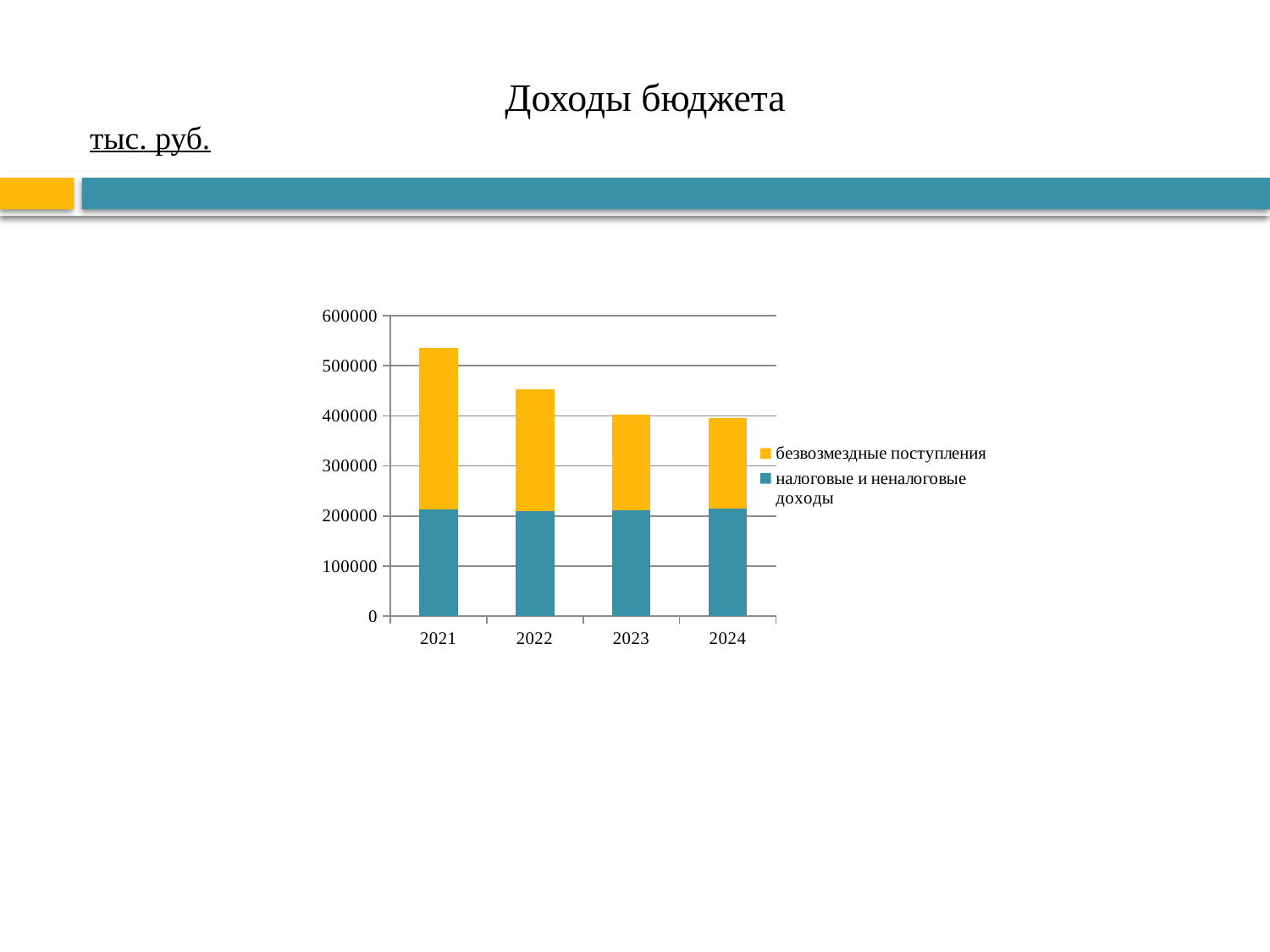
What kind of chart is shown on the slide? stacked bar chart Is the total bar for 2023 greater or less than 500000? less How many series does the chart legend list? 2 How many years are shown on the x axis of the chart? 4 Is the value of налоговые и неналоговые доходы for 2021 greater or less than 300000? less Which is larger, the total bar for 2021 or the total bar for 2022? 2021 Which year has the tallest total bar? 2021 Is the total bar for 2022 greater or less than 500000? less In what units are the values on the chart given, according to the slide? тыс. руб. What is the title of the chart on the slide? Доходы бюджета Do the total bar heights rise or fall from 2021 to 2024? fall